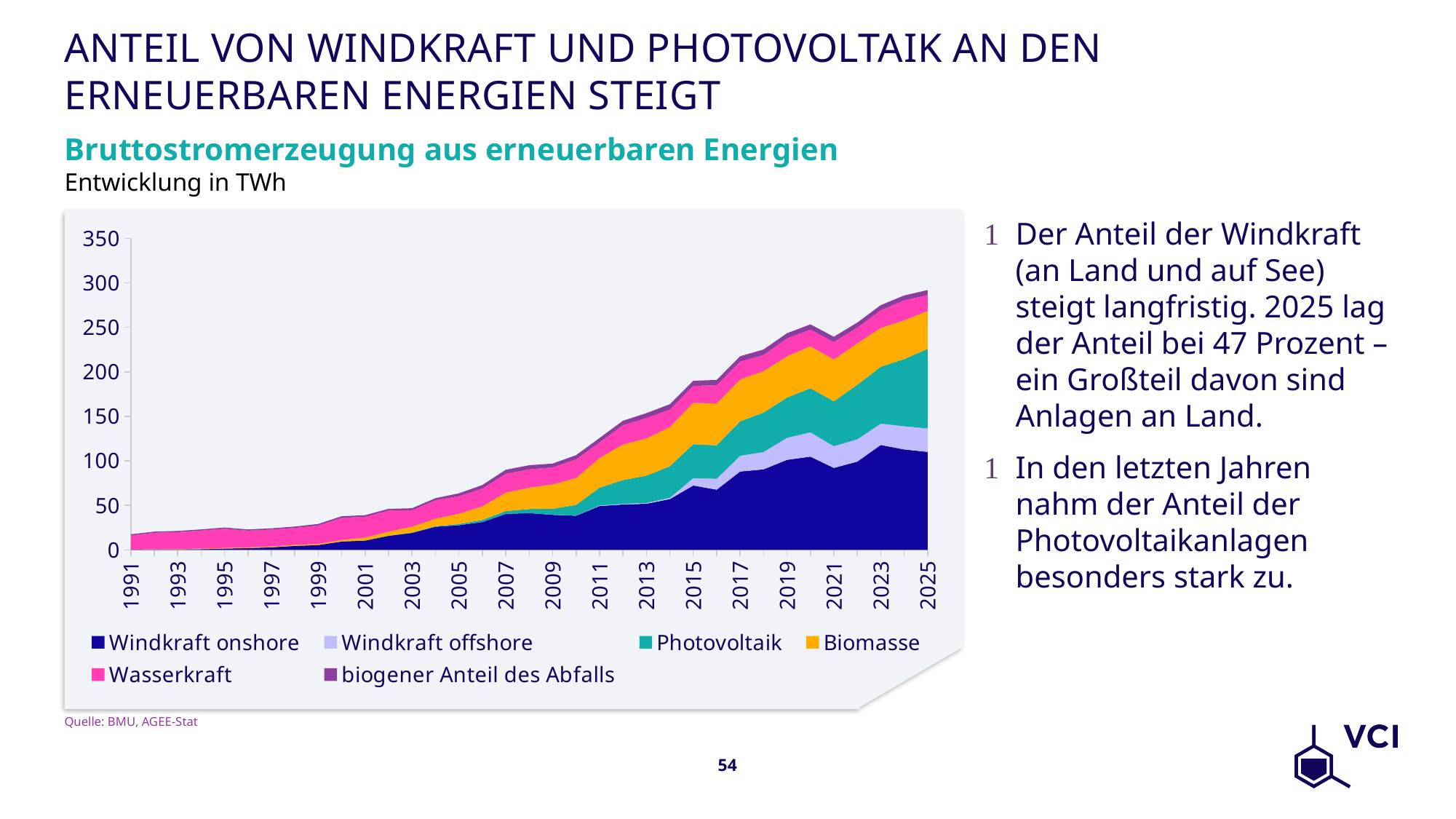
Is the total value for 2025 greater or less than 250? greater Which is larger, the total value for 2025 or the total value for 2011? 2025 What is the title of the chart? Bruttostromerzeugung aus erneuerbaren Energien In which unit are the values on the chart given? TWh Is the total value for 2015 greater or less than 150? greater Does the total gross electricity generation from renewables rise or fall from 1991 to 2025? Rise Which series contributes the most in 2025? Windkraft onshore What kind of chart is shown on the slide? Stacked area chart Is the value for Windkraft onshore in 2025 greater or less than 100? greater What is the last year shown on the x axis? 2025 How many series does the legend list? 6